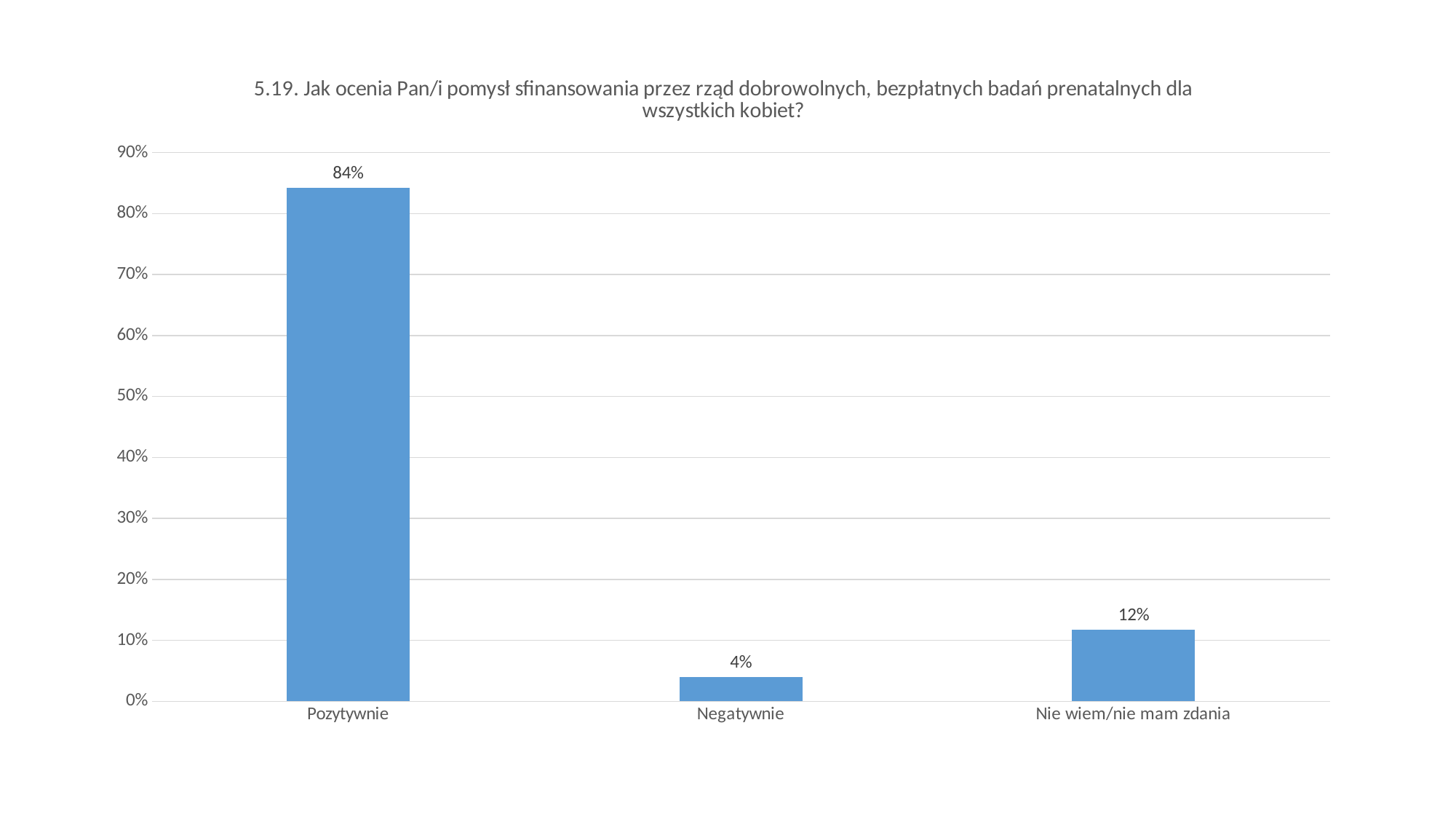
What is the value for Negatywnie? 4% What kind of chart is shown on the slide? bar chart Which is larger, the value for Negatywnie or the value for Nie wiem/nie mam zdania? Nie wiem/nie mam zdania What is the highest value shown on the vertical axis? 90% What is the difference between the values for Nie wiem/nie mam zdania and Negatywnie? 8% Is the value for Pozytywnie greater or less than 80%? greater What is the value for Nie wiem/nie mam zdania? 12% Which category has the highest value? Pozytywnie Which category has the lowest value? Negatywnie What is the value for Pozytywnie? 84% What is the difference between the values for Pozytywnie and Nie wiem/nie mam zdania? 72% How many categories are shown on the x axis? 3